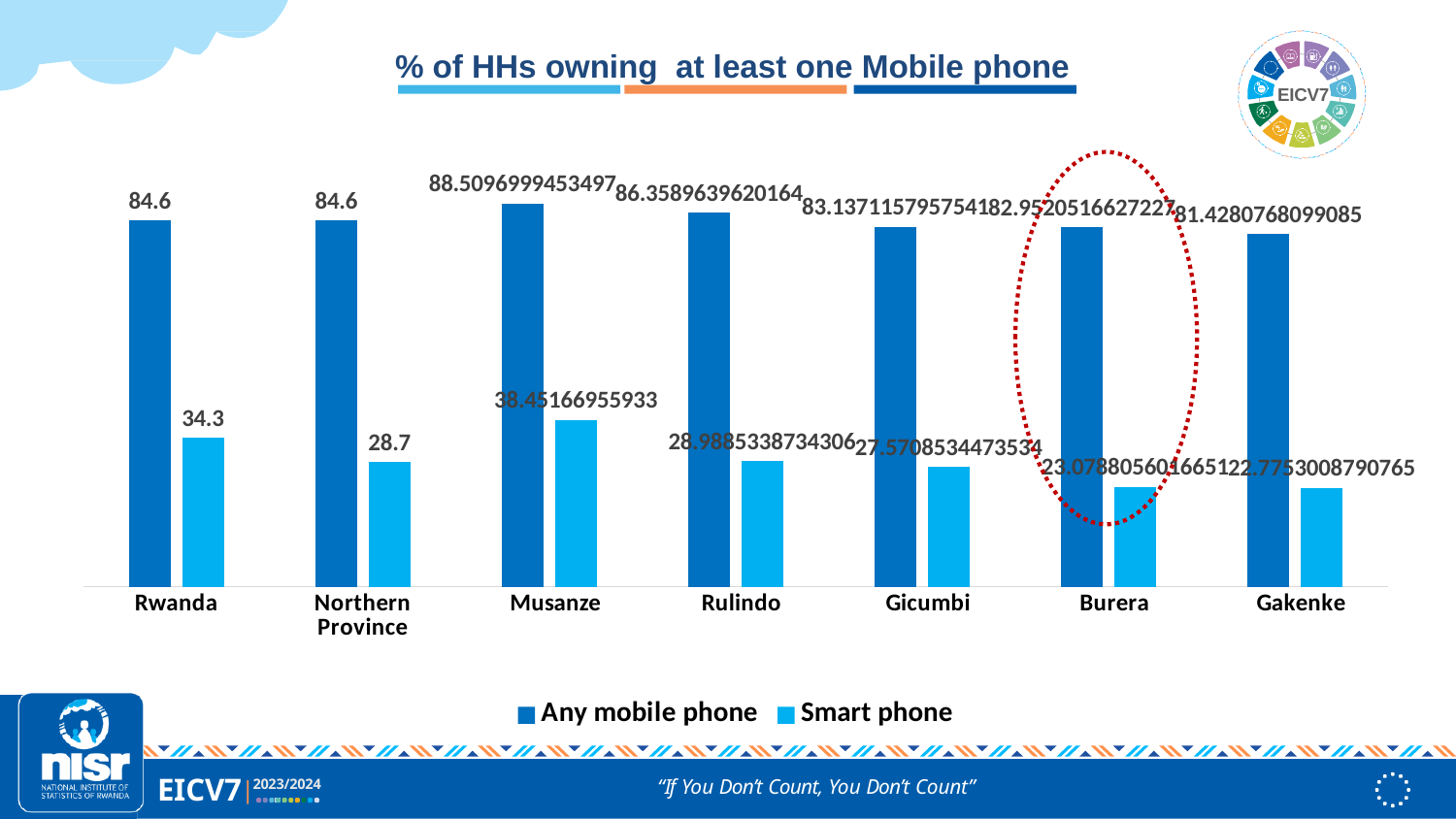
What is the value for Any mobile phone in Musanze? 88.5096999453497 What is the value for Smart phone in Rwanda? 34.3 How many categories are shown on the x axis? 7 How many series does the legend list? 2 What is the difference between Any mobile phone and Smart phone in Rwanda? 50.3 What is the value for Smart phone in Northern Province? 28.7 Which category is highlighted with a red dotted circle? Burera Which category has the highest value for Any mobile phone? Musanze Which category has the highest value for Smart phone? Musanze Which is larger: the Smart phone value for Rwanda or for Northern Province? Rwanda What kind of chart is shown on the slide? Bar chart What is the value for Any mobile phone in Rwanda? 84.6